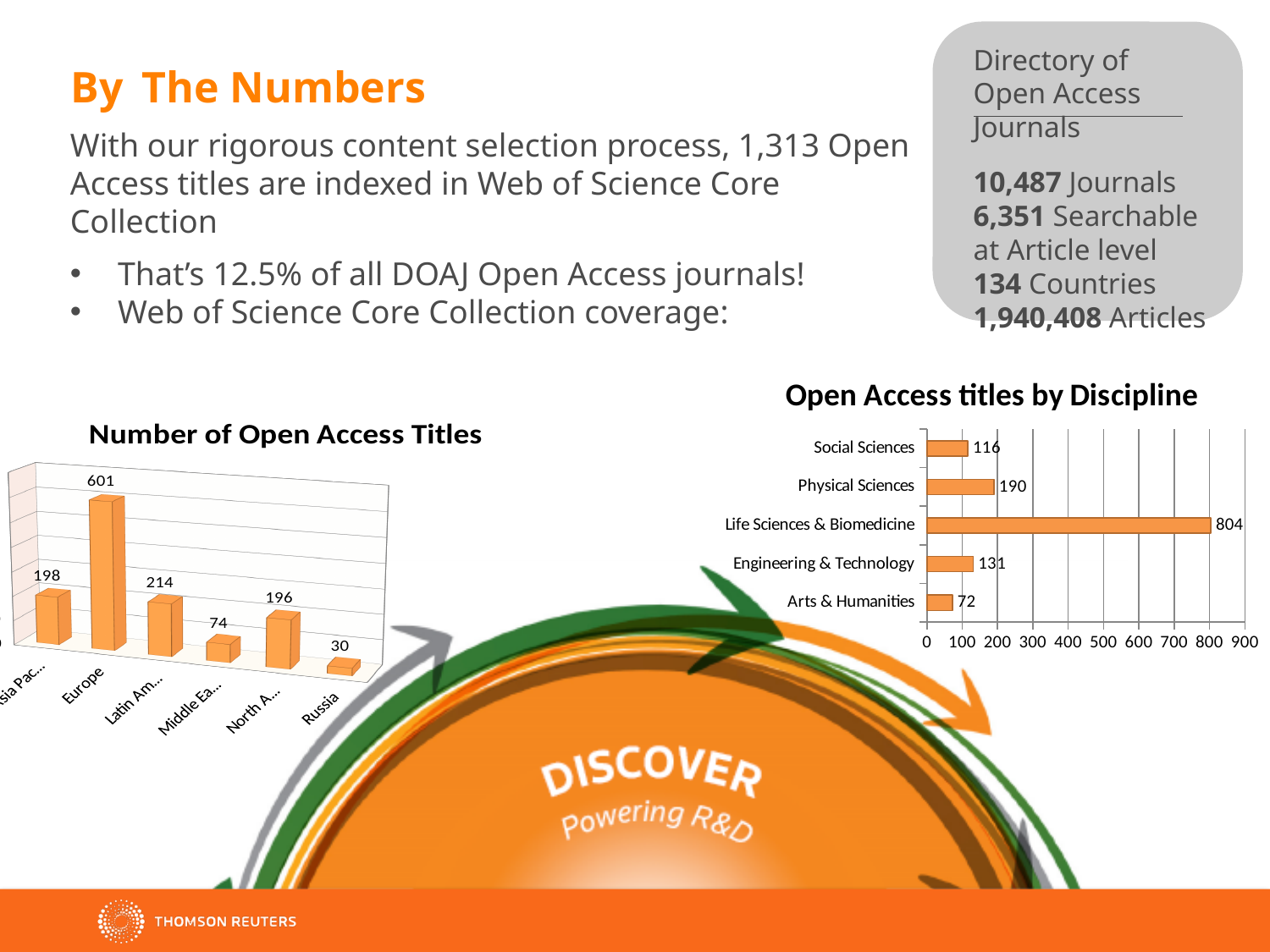
In the 'Number of Open Access Titles' chart, what is the value for Russia? 30 In the 'Number of Open Access Titles' chart, what is the value for Europe? 601 In the 'Open Access titles by Discipline' chart, how many disciplines are shown? 5 In the 'Number of Open Access Titles' chart, which region has the highest value? Europe In the 'Open Access titles by Discipline' chart, which discipline has the highest value? Life Sciences & Biomedicine In the 'Open Access titles by Discipline' chart, what is the value for Physical Sciences? 190 In the 'Number of Open Access Titles' chart, what is the difference between Europe and Russia? 571 In the 'Open Access titles by Discipline' chart, which is larger: Engineering & Technology or Social Sciences? Engineering & Technology What kind of chart is 'Open Access titles by Discipline'? Bar chart In the 'Open Access titles by Discipline' chart, what is the difference between Physical Sciences and Social Sciences? 74 In the 'Open Access titles by Discipline' chart, which discipline has the lowest value? Arts & Humanities In the 'Open Access titles by Discipline' chart, what is the value for Life Sciences & Biomedicine? 804